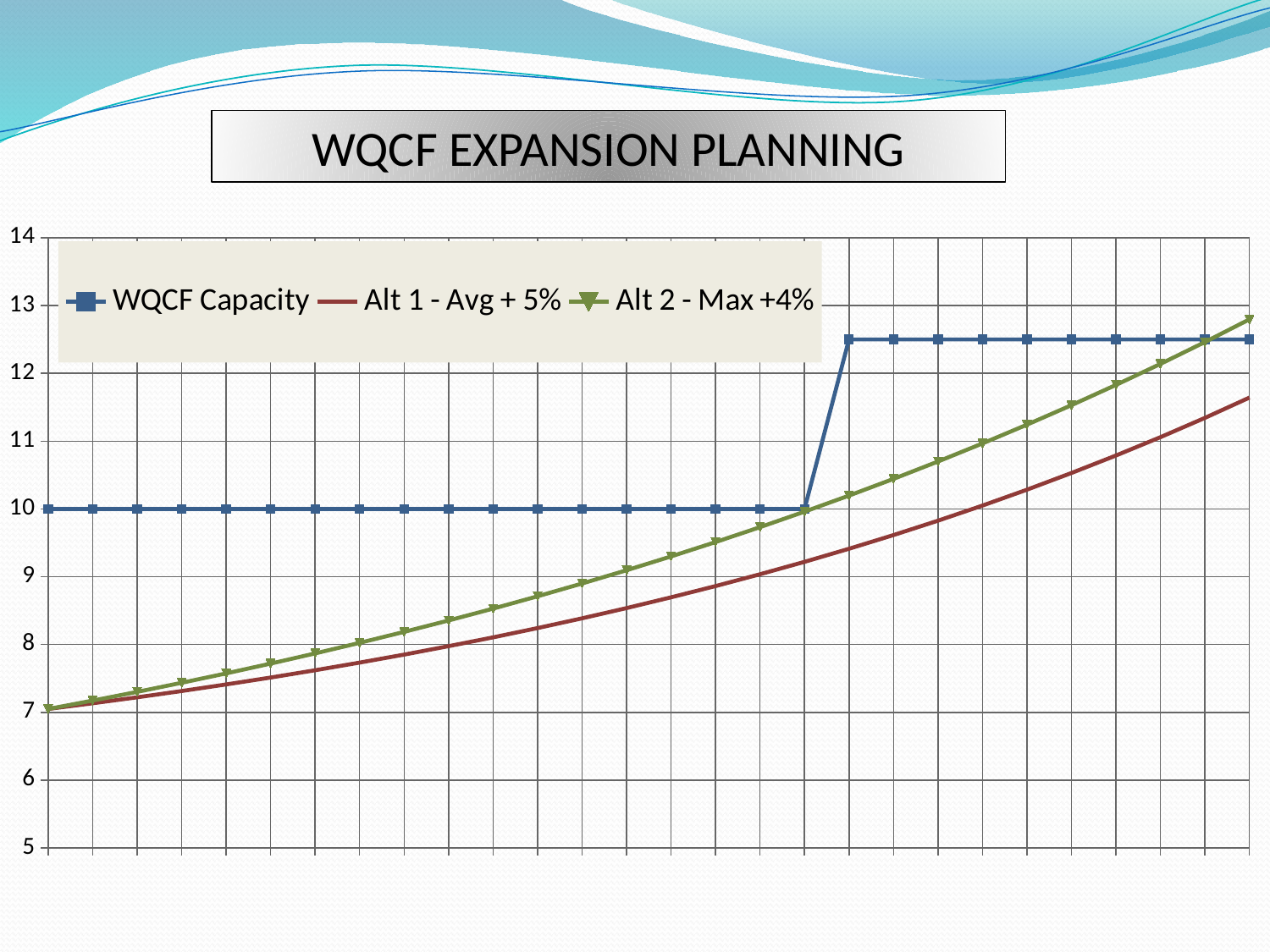
At the right end of the chart, which is higher: Alt 1 - Avg + 5% or Alt 2 - Max +4%? Alt 2 - Max +4% At the right end of the chart, is the value of Alt 2 - Max +4% greater or less than 12? greater What kind of chart is shown on the slide? line chart After the WQCF Capacity line steps up, is its value greater or less than 12? greater What are the three series named in the legend? WQCF Capacity, Alt 1 - Avg + 5%, Alt 2 - Max +4% At the left end of the chart, is the value of Alt 2 - Max +4% greater or less than 8? less What value does the WQCF Capacity line hold over the left portion of the chart, before it steps up? 10 What is the title of the slide above the chart? WQCF EXPANSION PLANNING Does the Alt 1 - Avg + 5% line rise or fall from left to right? rise Does the Alt 2 - Max +4% line rise or fall from left to right? rise How many series does the chart legend list? 3